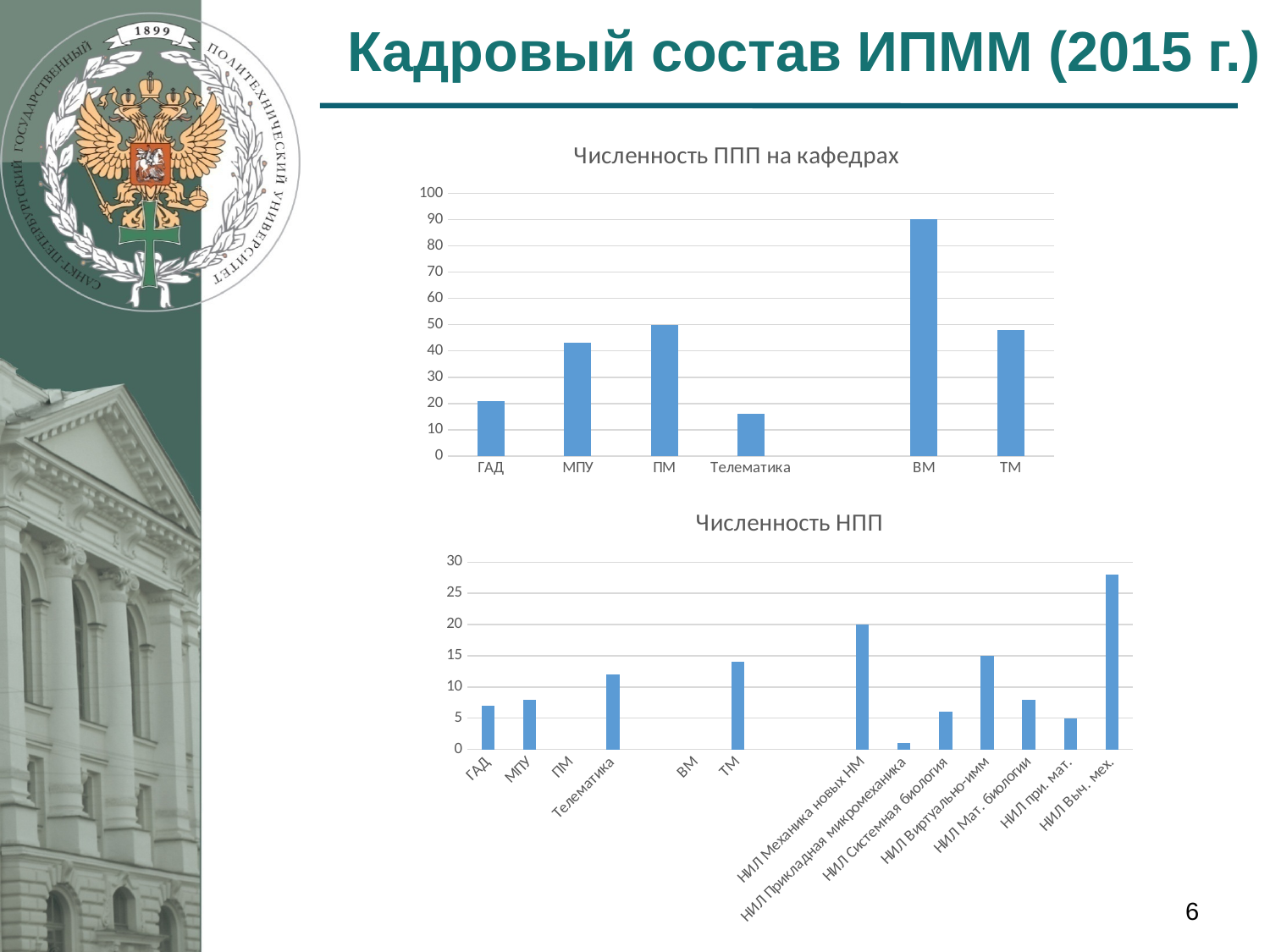
In the chart titled 'Численность НПП', is the value for Телематика greater or less than 10? greater In the chart titled 'Численность ППП на кафедрах', which category has the lowest value? Телематика In the chart titled 'Численность ППП на кафедрах', which category has the highest value? ВМ In the chart titled 'Численность НПП', what is the value for НИЛ Механика новых НМ? 20 In the chart titled 'Численность ППП на кафедрах', which is larger, the value for ПМ or the value for ТМ? ПМ In the chart titled 'Численность НПП', which category has the highest value? НИЛ Выч. мех. In the chart titled 'Численность ППП на кафедрах', is the value for ГАД greater or less than 30? less In the chart titled 'Численность ППП на кафедрах', is the value for МПУ greater or less than 40? greater In the chart titled 'Численность НПП', which is larger, the value for ТМ or the value for НИЛ Системная биология? ТМ How many labelled categories are shown on the x axis of the chart titled 'Численность ППП на кафедрах'? 6 What type of chart is the chart titled 'Численность НПП'? bar chart In the chart titled 'Численность ППП на кафедрах', what is the value for ВМ? 90